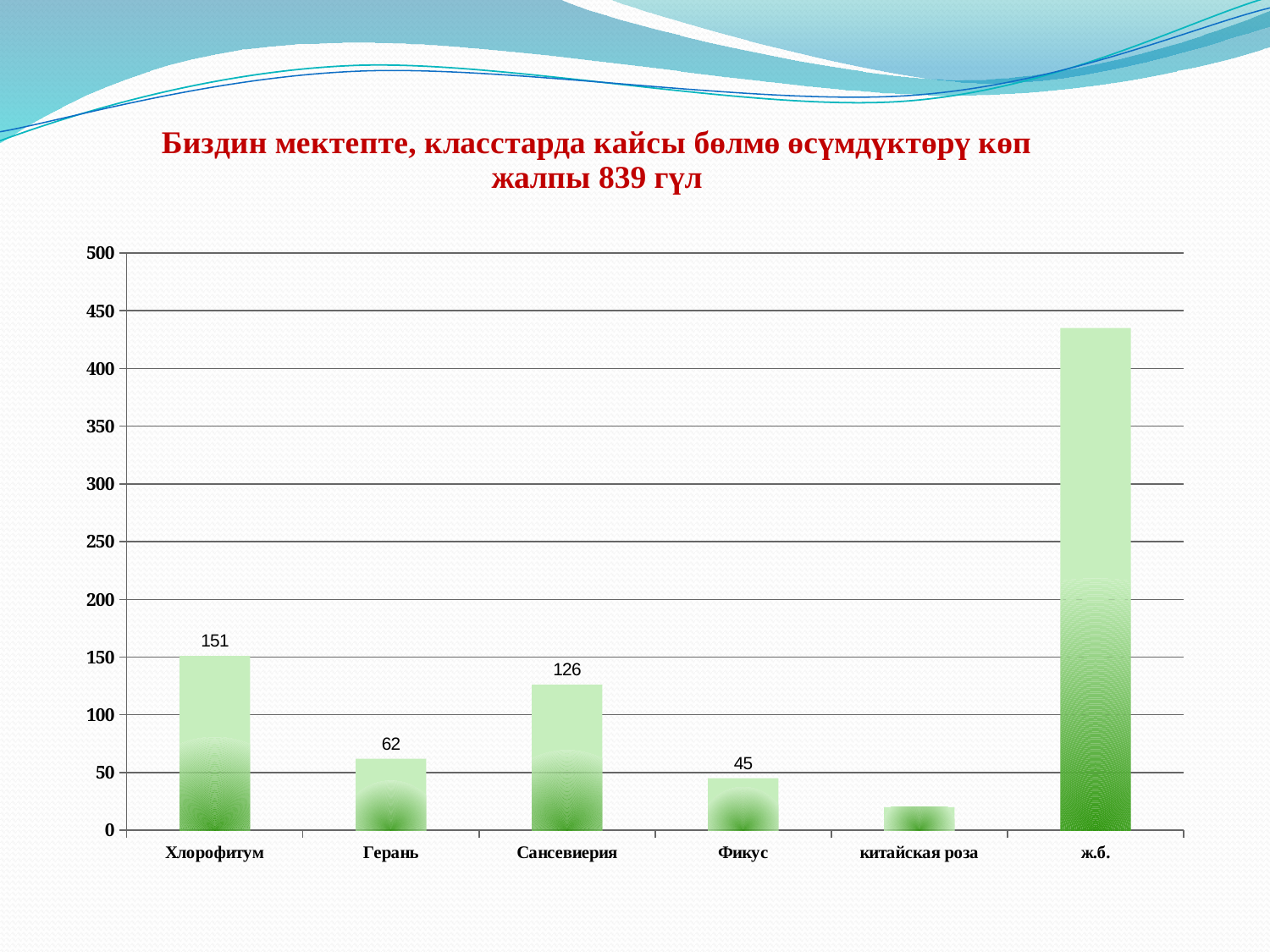
What is the difference between the values for Хлорофитум and Сансевиерия? 25 How many categories are shown on the x axis? 6 What is the value for Хлорофитум? 151 Is the value for китайская роза greater or less than 50? less Which category has the highest bar? ж.б. What is the value for Фикус? 45 Which category has the lowest bar? китайская роза What is the value for Герань? 62 What is the value for Сансевиерия? 126 Which is larger, the value for Герань or the value for Фикус? Герань Is the value for ж.б. greater or less than 400? greater What kind of chart is shown on the slide? bar chart